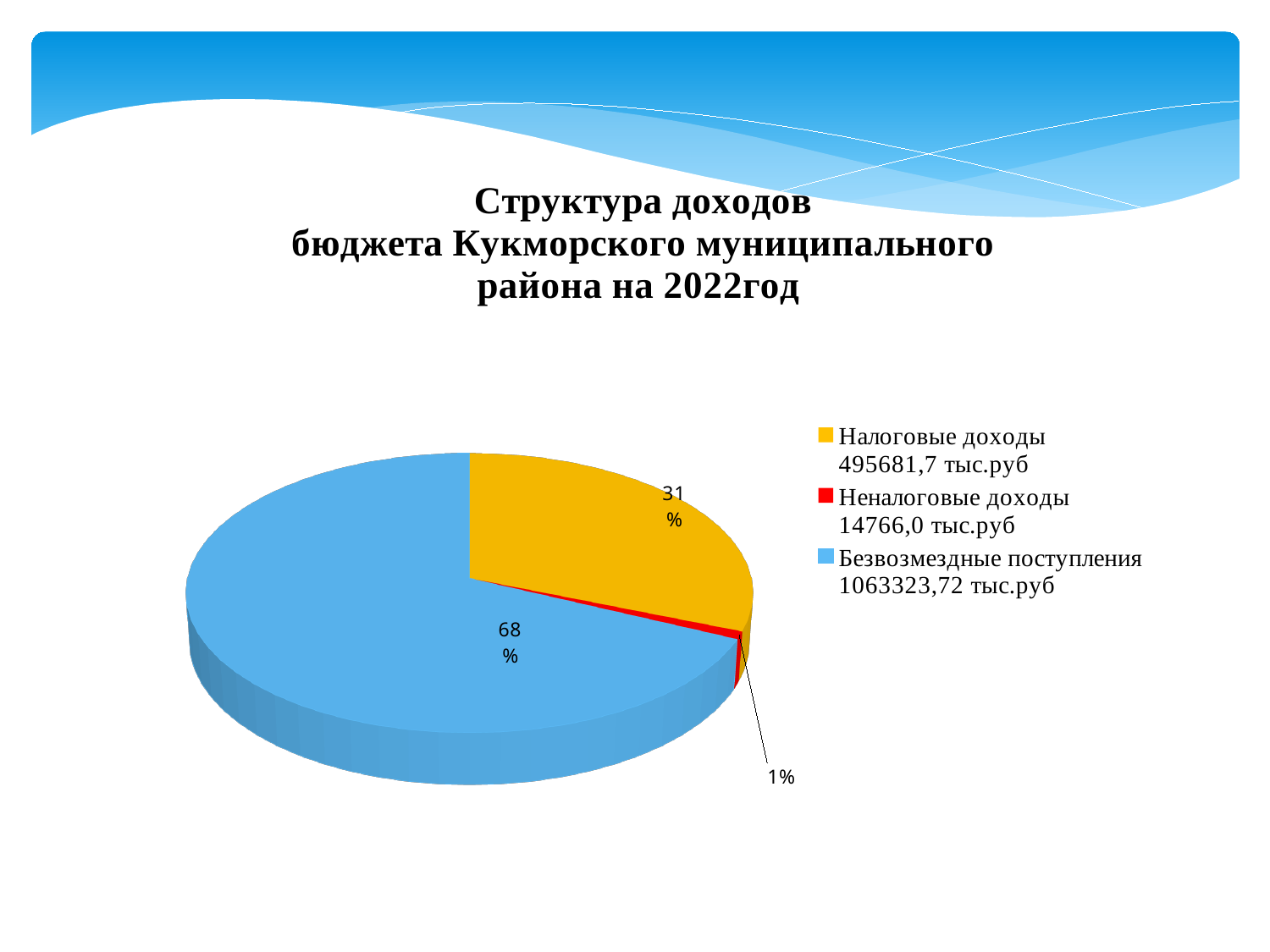
Which category has the smallest slice of the pie? Неналоговые доходы Which is larger, Налоговые доходы or Неналоговые доходы? Налоговые доходы How many categories does the pie chart have? 3 What kind of chart is shown on the slide? pie chart What is the difference in percentage points between the shares of Безвозмездные поступления and Налоговые доходы? 37% What is the value for Неналоговые доходы shown in the legend? 14766,0 тыс.руб What is the value for Налоговые доходы shown in the legend? 495681,7 тыс.руб What share of the pie does Неналоговые доходы take? 1% What share of the pie does Безвозмездные поступления take? 68% Which category has the largest slice of the pie? Безвозмездные поступления What share of the pie does Налоговые доходы take? 31% What is the value for Безвозмездные поступления shown in the legend? 1063323,72 тыс.руб